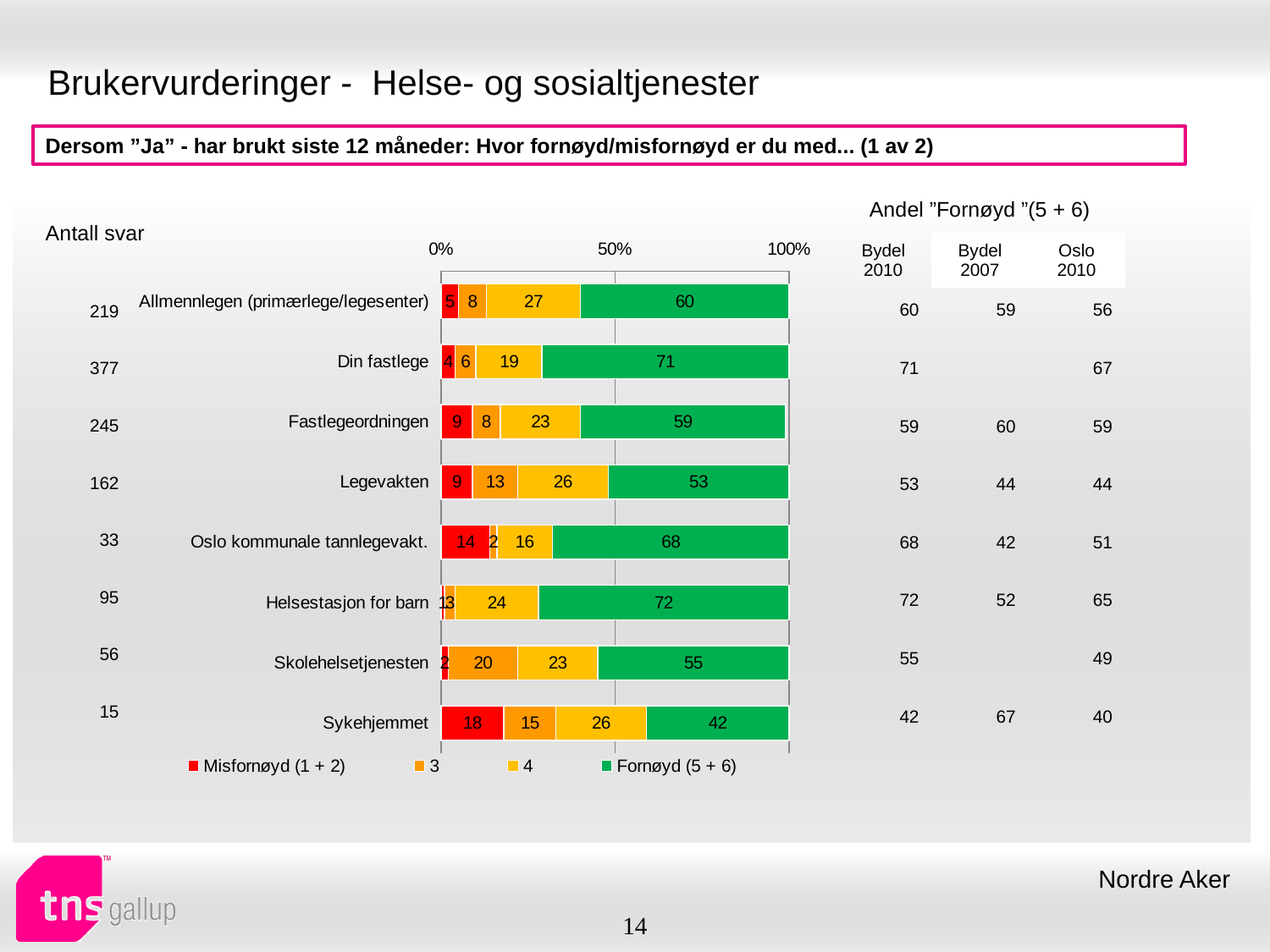
Which category has the highest "Fornøyd (5 + 6)" value? Helsestasjon for barn What is the value of series "3" for Skolehelsetjenesten? 20 How many series does the legend list? 4 How many categories are shown in the chart? 8 What is the value of series "4" for Legevakten? 26 What is the value of "Misfornøyd (1 + 2)" for Sykehjemmet? 18 Which has the larger "Misfornøyd (1 + 2)" value, Legevakten or Oslo kommunale tannlegevakt.? Oslo kommunale tannlegevakt. What is the value of "Fornøyd (5 + 6)" for Din fastlege? 71 What kind of chart is shown on the slide? Stacked bar chart What is the difference between the "Fornøyd (5 + 6)" values for Din fastlege and Sykehjemmet? 29 Which legend entry is shown in green? Fornøyd (5 + 6) Which category has the lowest "Fornøyd (5 + 6)" value? Sykehjemmet